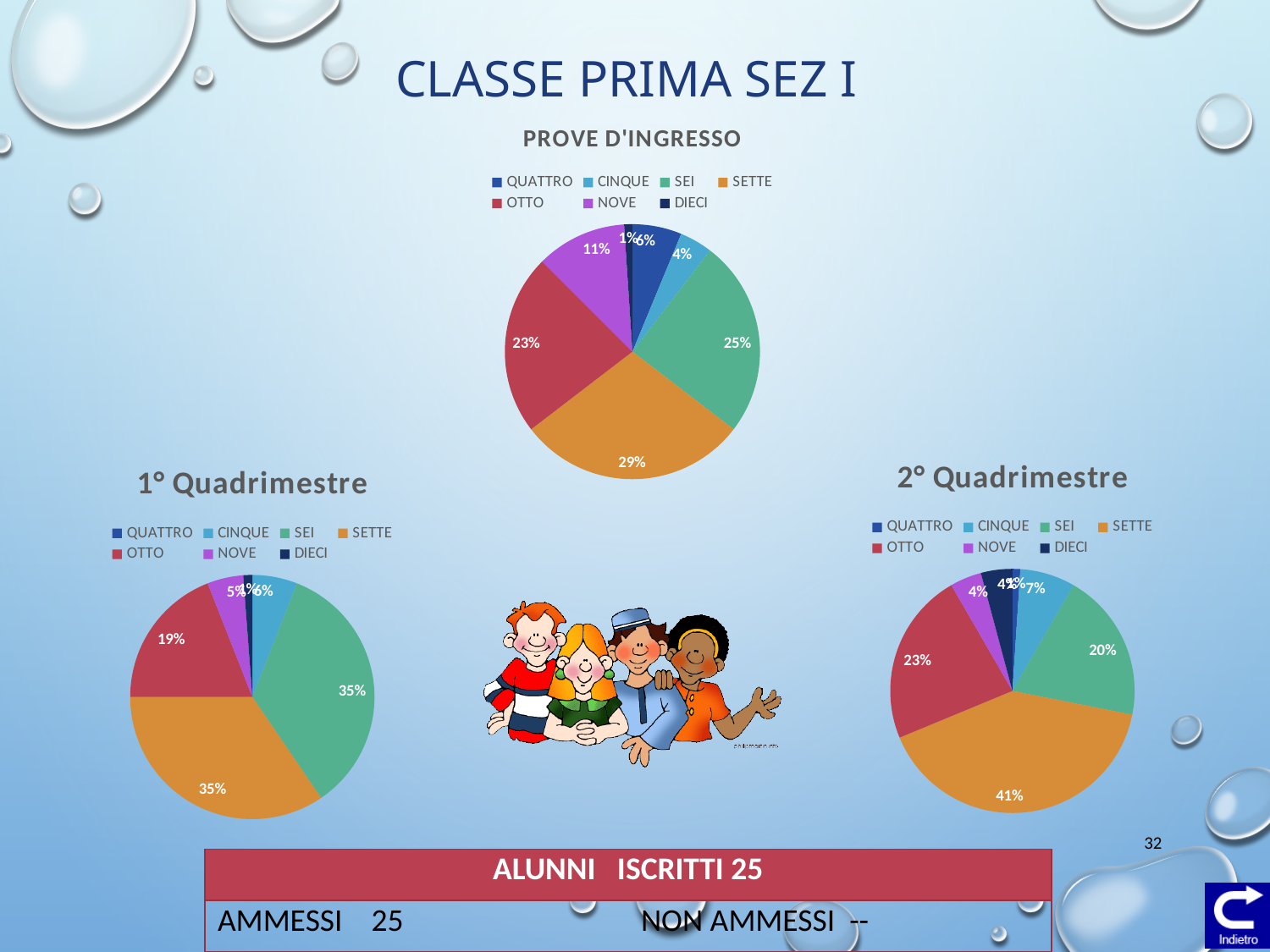
In the PROVE D'INGRESSO chart, what percentage is OTTO? 23% In the 2° Quadrimestre chart, what percentage is SETTE? 41% In the PROVE D'INGRESSO chart, what percentage is SETTE? 29% In the 1° Quadrimestre chart, what percentage is SEI? 35% What type of chart is used for PROVE D'INGRESSO? pie chart In the 2° Quadrimestre chart, which category has the largest share? SETTE In the 1° Quadrimestre chart, what percentage is OTTO? 19% How many series does the legend of the PROVE D'INGRESSO chart list? 7 In the 2° Quadrimestre chart, what is the difference between OTTO and SEI? 3% In the PROVE D'INGRESSO chart, which category has the largest share? SETTE In the 1° Quadrimestre chart, which is larger, OTTO or NOVE? OTTO In the PROVE D'INGRESSO chart, what is the difference between SEI and NOVE? 14%